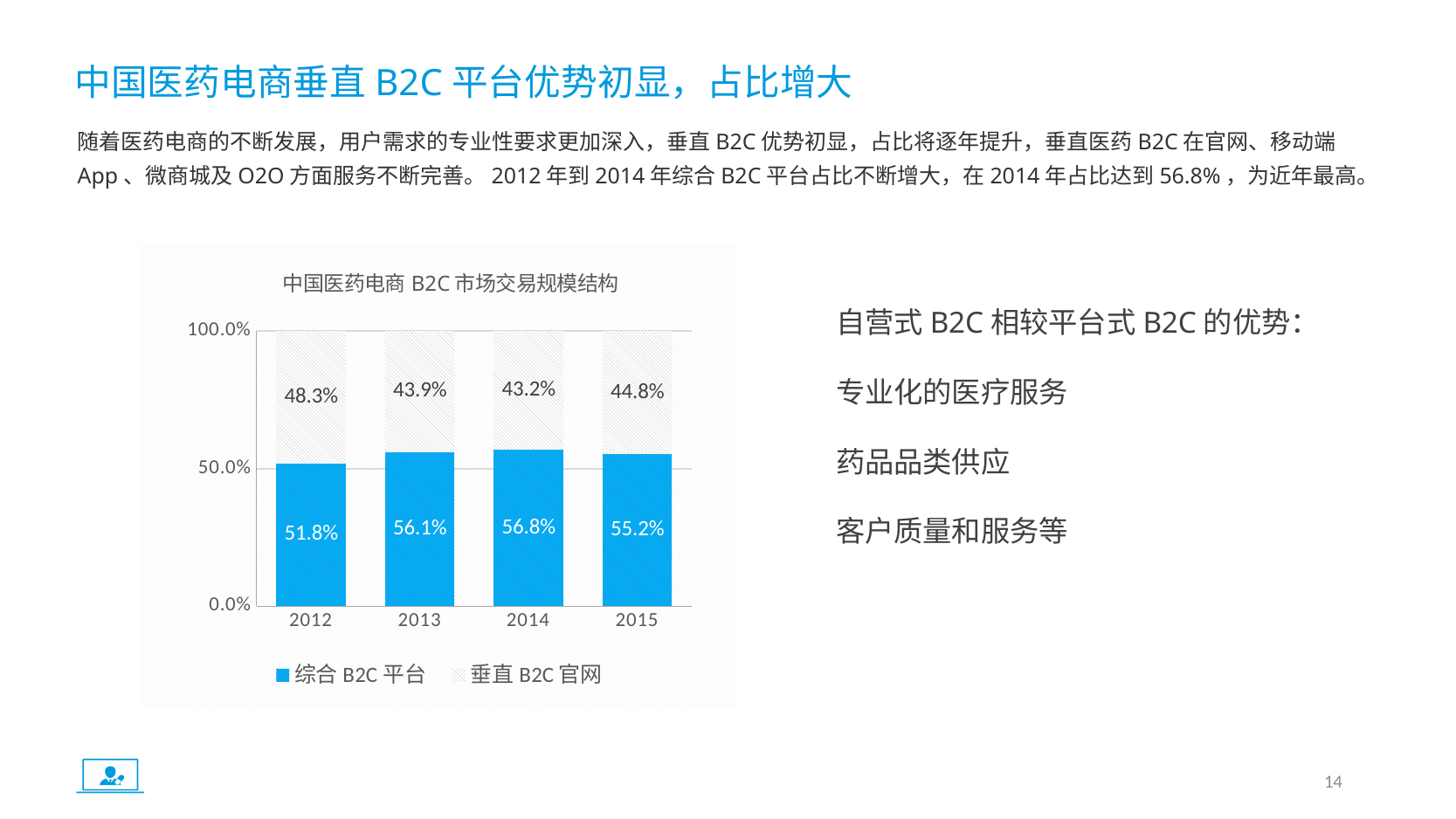
Is the value for 综合 B2C 平台 in 2012 greater or less than 50.0%? greater What is the difference between the 综合 B2C 平台 values for 2013 and 2012? 4.3% What kind of chart is shown? Stacked bar chart What is the value for 综合 B2C 平台 in 2015? 55.2% How many series does the legend list? 2 In which year is the 综合 B2C 平台 share highest? 2014 What is the title of the chart? 中国医药电商 B2C 市场交易规模结构 Which is larger in 2015: 综合 B2C 平台 or 垂直 B2C 官网? 综合 B2C 平台 What is the value for 垂直 B2C 官网 in 2012? 48.3% What is the value for 综合 B2C 平台 in 2014? 56.8% How many years are shown on the x axis? 4 In which year is the 垂直 B2C 官网 share lowest? 2014